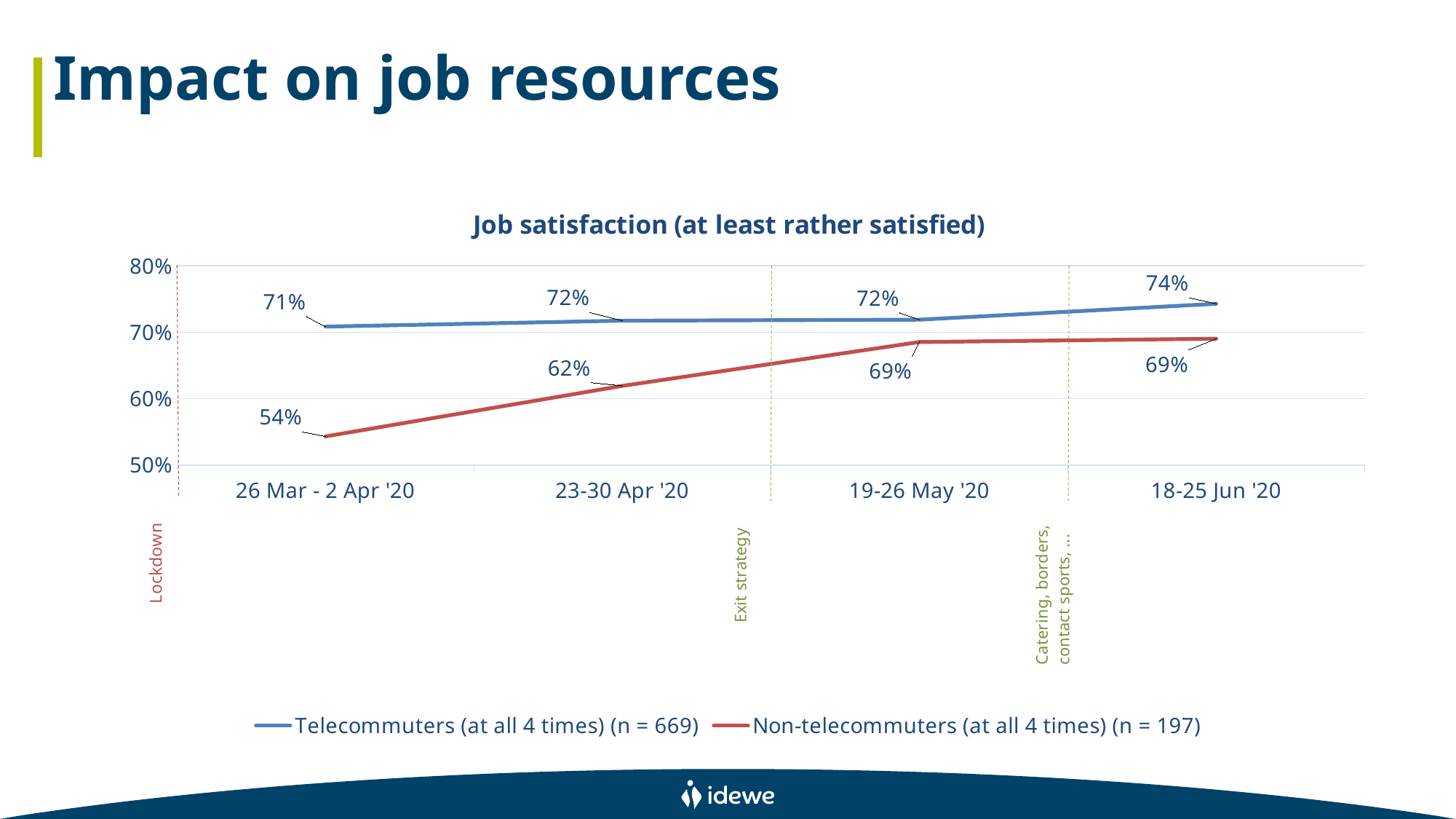
How many series does the legend list? 2 Which series has the larger value in the 19-26 May '20 period, Telecommuters or Non-telecommuters? Telecommuters In which period is the Non-telecommuters value lowest? 26 Mar - 2 Apr '20 What is the job satisfaction value for Non-telecommuters in the 26 Mar - 2 Apr '20 period? 54% How many time periods are shown on the x axis? 4 What kind of chart is shown on the slide? Line chart What is the difference between the Telecommuters and Non-telecommuters values in the 26 Mar - 2 Apr '20 period? 17% What is the job satisfaction value for Non-telecommuters in the 23-30 Apr '20 period? 62% What is the job satisfaction value for Telecommuters in the 26 Mar - 2 Apr '20 period? 71% In which period is the Telecommuters value highest? 18-25 Jun '20 What is the job satisfaction value for Telecommuters in the 18-25 Jun '20 period? 74% Does the Non-telecommuters series rise or fall from 26 Mar - 2 Apr '20 to 19-26 May '20? Rise